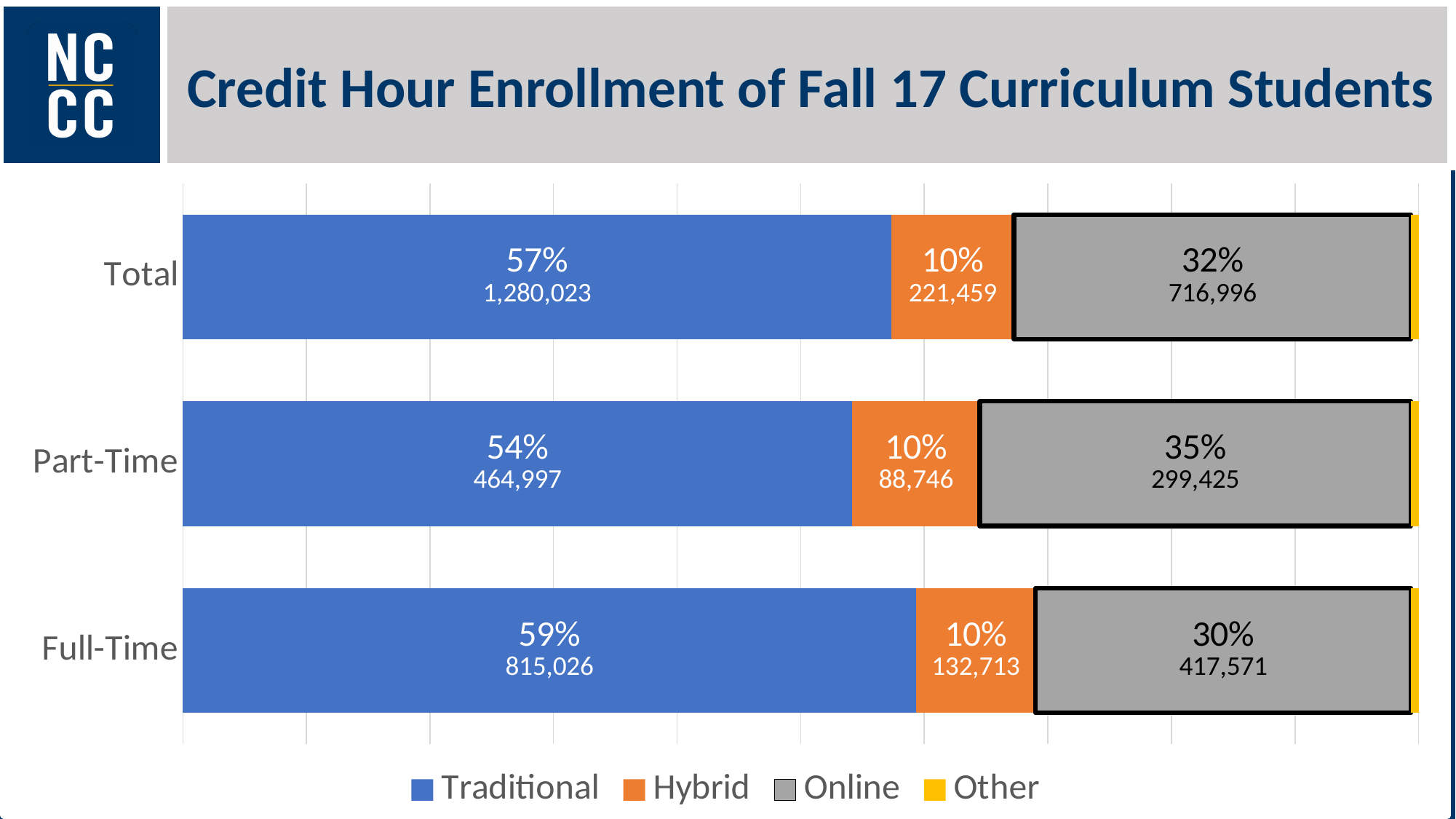
What is the difference between the Traditional credit hours for Full-Time and Part-Time students? 350,029 What percentage of Full-Time credit hours is Online? 30% How many categories are shown on the chart? 3 What is the title of the chart? Credit Hour Enrollment of Fall 17 Curriculum Students What is the Online credit hour count for Part-Time students? 299,425 What kind of chart is shown on the slide? Stacked bar chart Which is larger, the Online percentage for Part-Time or for Total? Part-Time How many series does the legend list? 4 Which category has the lowest Online percentage? Full-Time What percentage of Total credit hours is Traditional? 57% What is the Hybrid credit hour count for Full-Time students? 132,713 Which category has the highest Traditional percentage? Full-Time